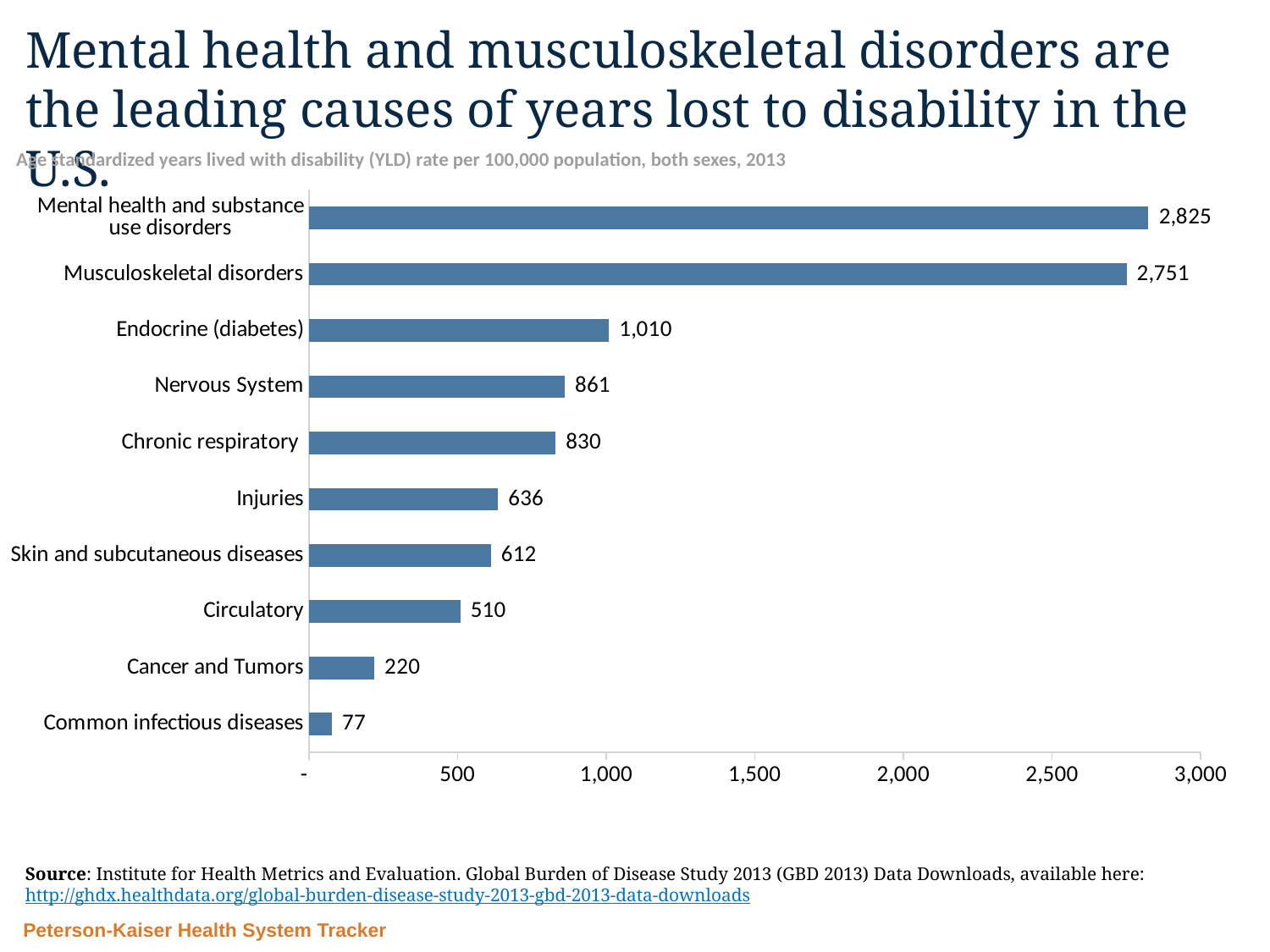
What is the YLD rate for Endocrine (diabetes)? 1,010 How many categories are shown in the chart? 10 What is the maximum value shown on the horizontal axis? 3,000 What is the difference between the values for Nervous System and Chronic respiratory? 31 Which category has the lowest YLD rate? Common infectious diseases What kind of chart is shown on the slide? Bar chart Is the value for Cancer and Tumors greater or less than 500? less What is the value shown for Common infectious diseases? 77 Which is larger, the value for Injuries or the value for Circulatory? Injuries Which category has the highest YLD rate? Mental health and substance use disorders What is the difference between the values for Mental health and substance use disorders and Musculoskeletal disorders? 74 What is the YLD rate for Musculoskeletal disorders? 2,751